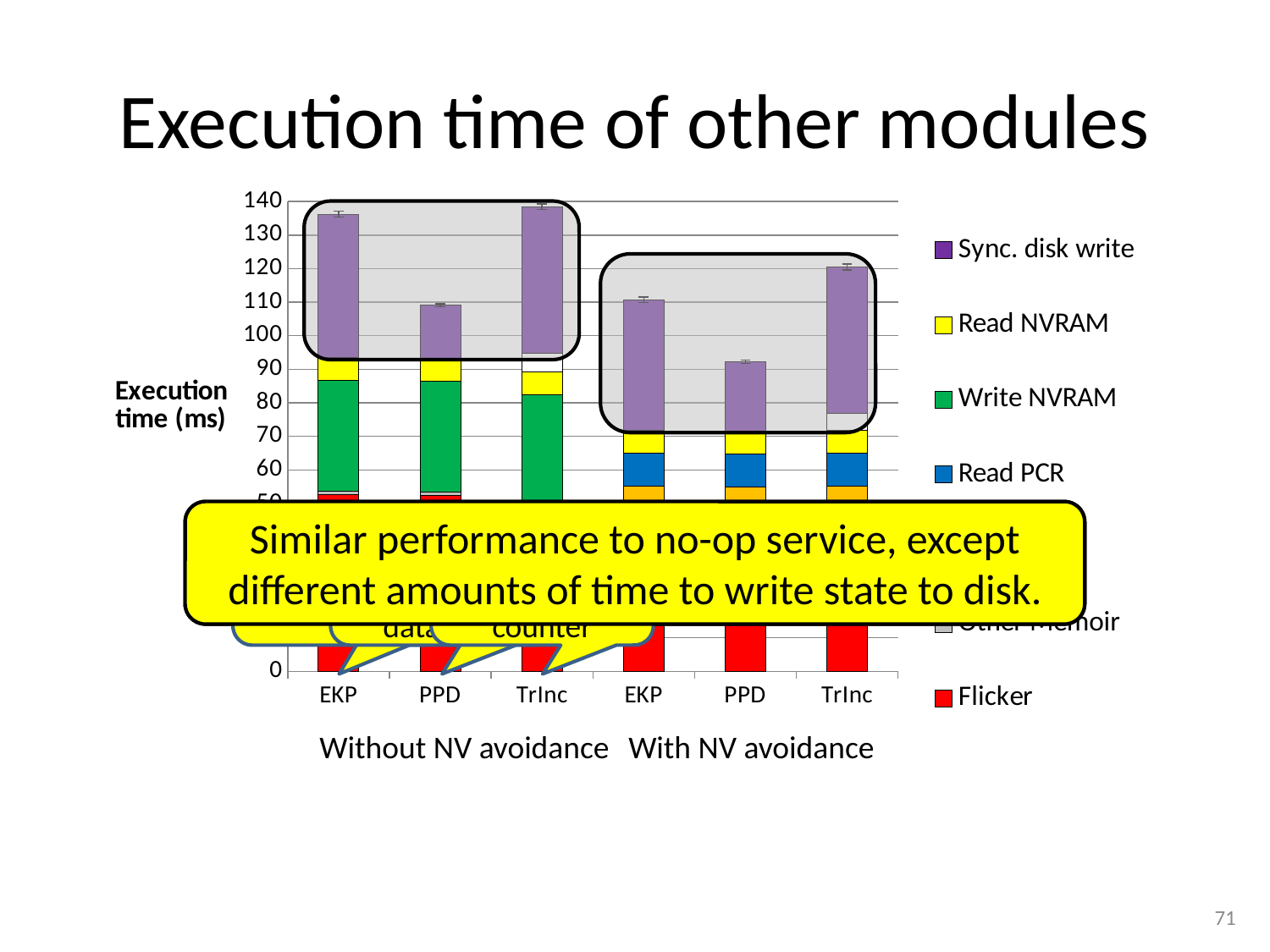
How many bars are plotted in the chart? 6 Is the total execution time for PPD with NV avoidance greater or less than 100? less What is the label of the vertical axis? Execution time (ms) Which has the larger total execution time: EKP without NV avoidance or EKP with NV avoidance? EKP without NV avoidance What kind of chart is shown on the slide? Stacked bar chart Which bar has the lowest total execution time? PPD with NV avoidance Is the total execution time for TrInc with NV avoidance greater or less than 110? greater What is the title of the chart on the slide? Execution time of other modules Is the total execution time for EKP without NV avoidance greater or less than 130? greater Which has the larger total execution time: TrInc without NV avoidance or PPD with NV avoidance? TrInc without NV avoidance